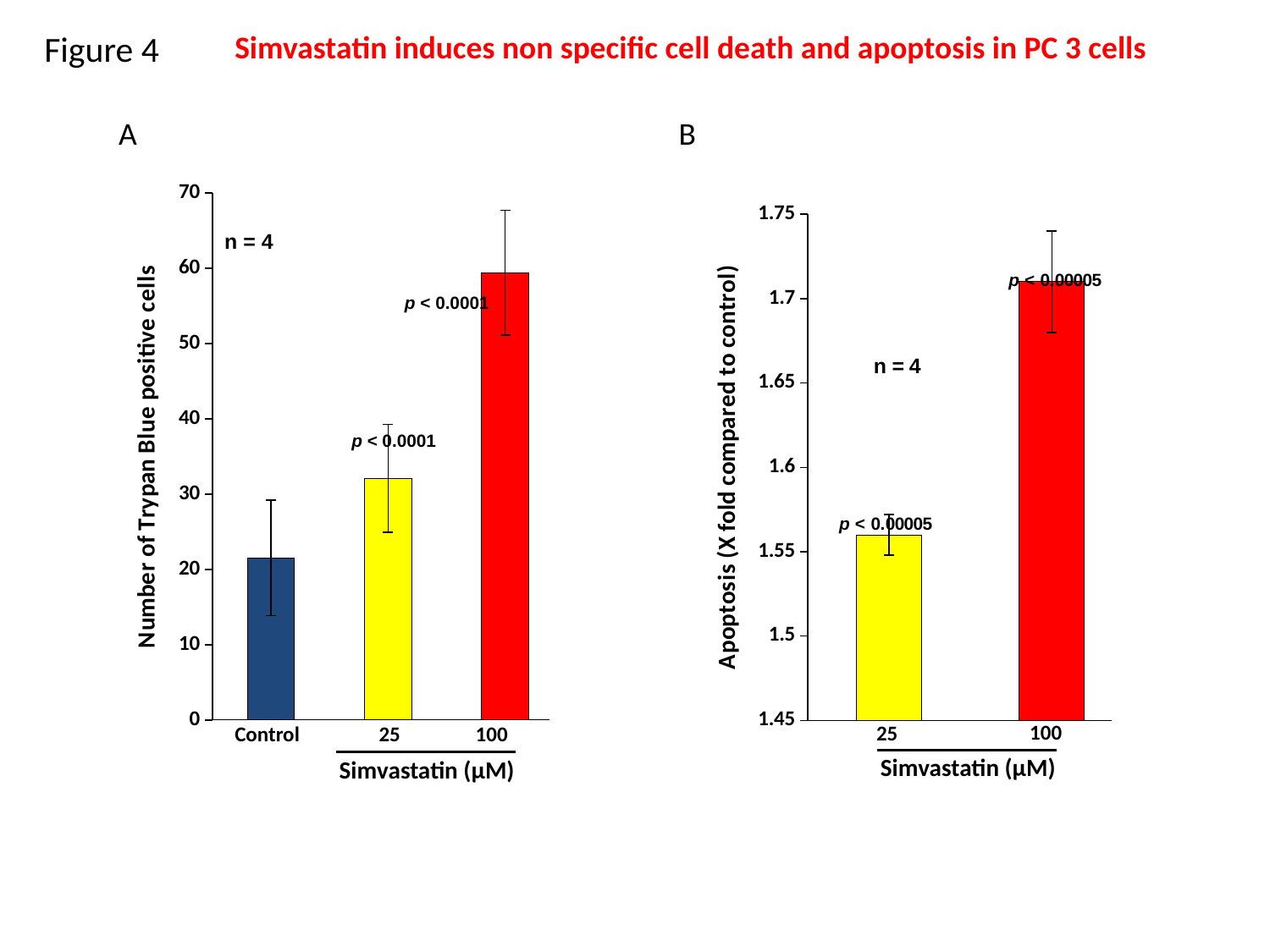
In chart A on the left, is the value for Control greater or less than 30? less In chart A on the left, is the value for 25 µM simvastatin greater or less than 40? less In chart B on the right, which concentration has the larger apoptosis value, 25 or 100? 100 What kind of chart is chart A on the left? bar chart In chart A on the left, which category has the highest number of Trypan Blue positive cells? 100 In chart B on the right, how many bars are plotted? 2 In chart A on the left, which category has the lowest number of Trypan Blue positive cells? Control What is the y-axis label of chart B on the right? Apoptosis (X fold compared to control) In chart B on the right, is the apoptosis value for 100 µM simvastatin greater or less than 1.65? greater In chart A on the left, how many bars are plotted? 3 In chart A on the left, do the values rise or fall from Control to 100 µM simvastatin? rise